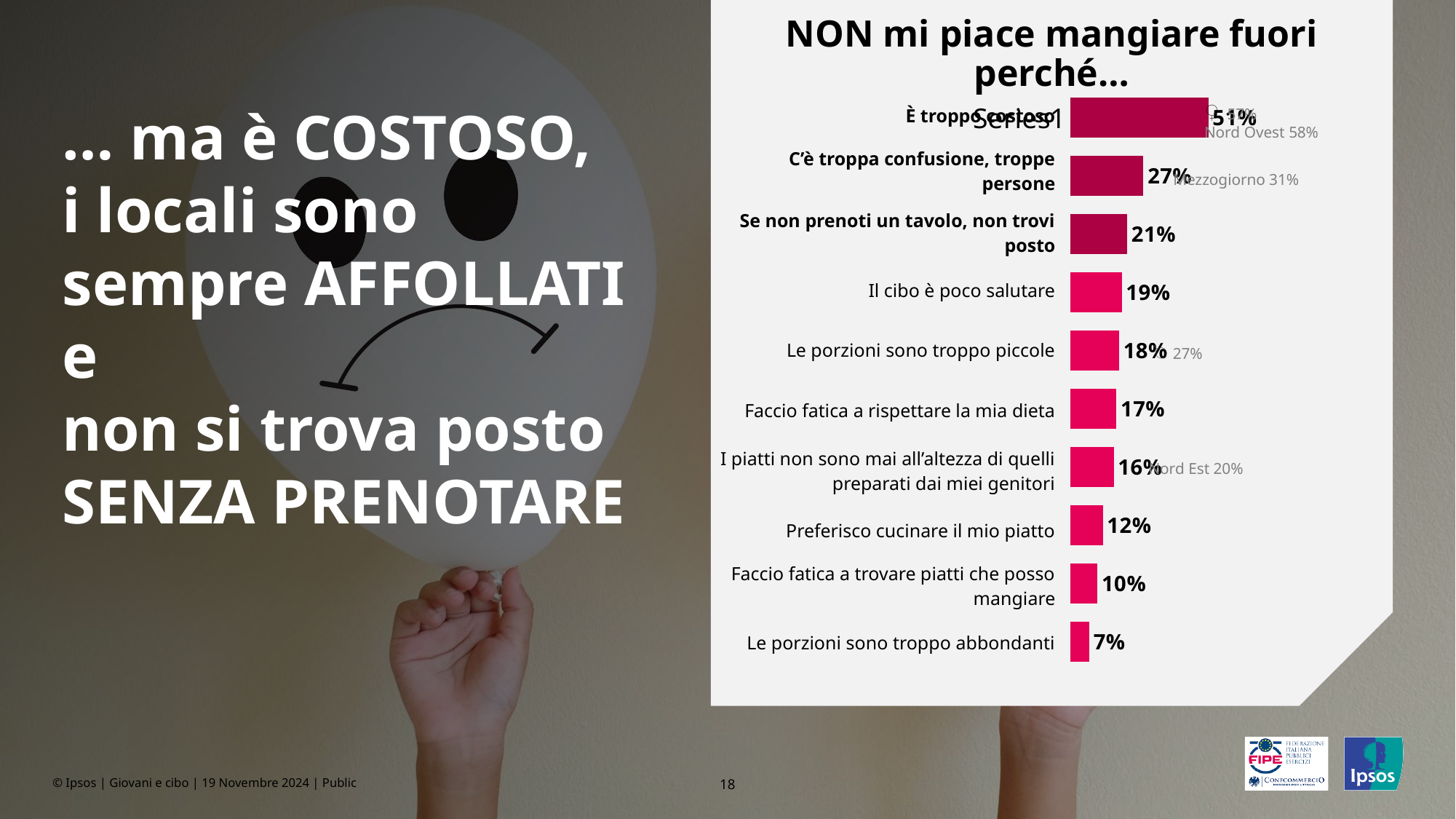
What is the value for "Preferisco cucinare il mio piatto"? 12% Which is larger, the value for "Il cibo è poco salutare" or the value for "Faccio fatica a trovare piatti che posso mangiare"? Il cibo è poco salutare What is the value for "C'è troppa confusione, troppe persone"? 27% Which category has the lowest value? Le porzioni sono troppo abbondanti How many categories does the chart show? 10 What is the value for "È troppo costoso"? 51% What kind of chart is shown on the slide? bar chart What is the difference between the values for "È troppo costoso" and "C'è troppa confusione, troppe persone"? 24% Which category has the highest value? È troppo costoso What is the value for "Se non prenoti un tavolo, non trovi posto"? 21% What is the title of the chart? NON mi piace mangiare fuori perché… What is the difference between the values for "Le porzioni sono troppo piccole" and "Le porzioni sono troppo abbondanti"? 11%